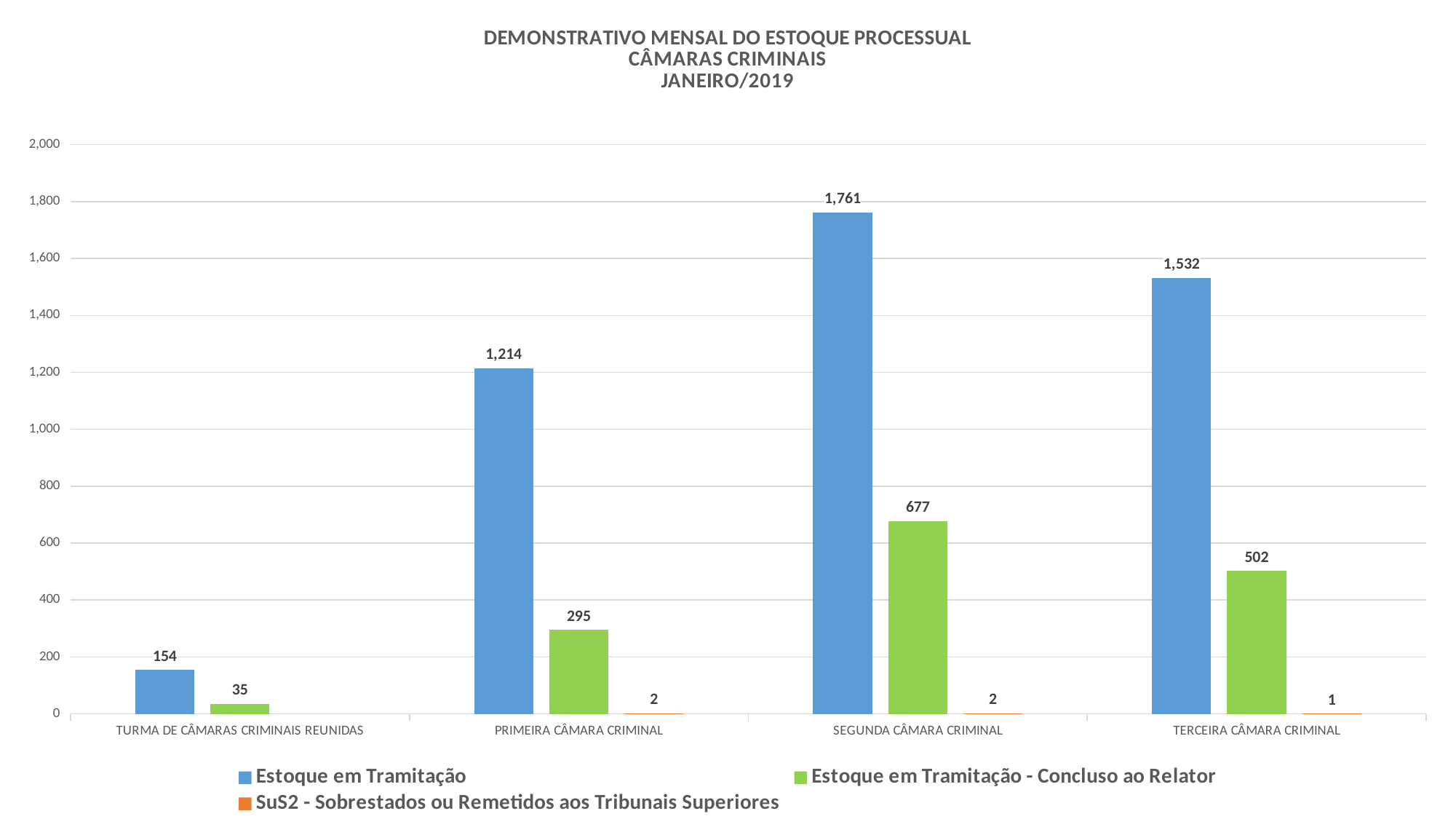
What is the value of SuS2 - Sobrestados ou Remetidos aos Tribunais Superiores for TERCEIRA CÂMARA CRIMINAL? 1 How many categories are shown on the x axis? 4 Which category has the highest value for Estoque em Tramitação? SEGUNDA CÂMARA CRIMINAL How many series does the legend list? 3 Which month and year does the chart title refer to? JANEIRO/2019 What is the value of Estoque em Tramitação - Concluso ao Relator for PRIMEIRA CÂMARA CRIMINAL? 295 Which category has the lowest value for Estoque em Tramitação - Concluso ao Relator? TURMA DE CÂMARAS CRIMINAIS REUNIDAS What is the difference between the Estoque em Tramitação values for SEGUNDA CÂMARA CRIMINAL and TERCEIRA CÂMARA CRIMINAL? 229 Is the value of Estoque em Tramitação for PRIMEIRA CÂMARA CRIMINAL greater or less than 1,000? greater Which is larger: Estoque em Tramitação - Concluso ao Relator for SEGUNDA CÂMARA CRIMINAL or for TERCEIRA CÂMARA CRIMINAL? SEGUNDA CÂMARA CRIMINAL What kind of chart is shown on the slide? bar chart What is the value of Estoque em Tramitação for SEGUNDA CÂMARA CRIMINAL? 1,761